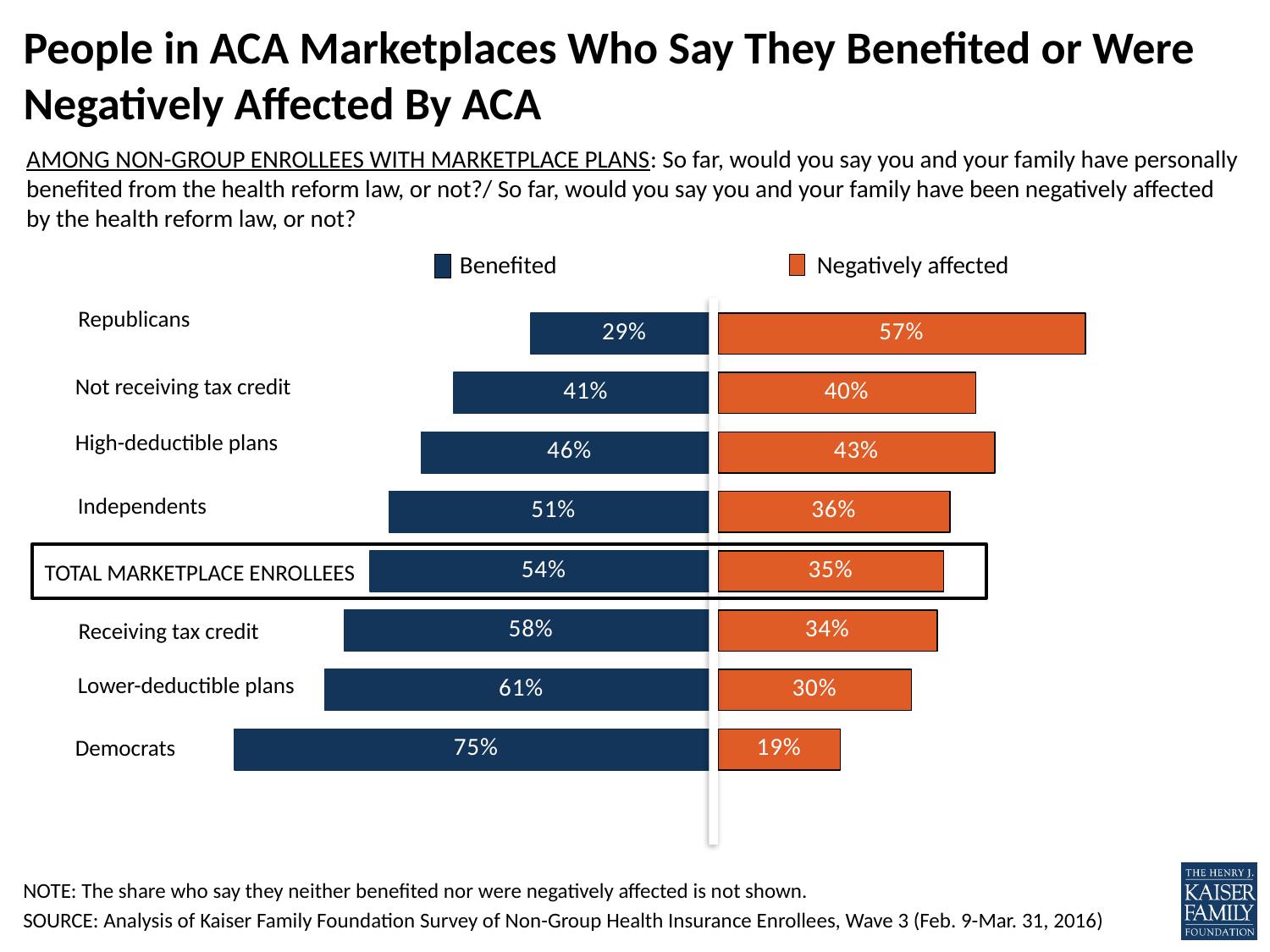
What percentage of Republicans say they benefited from the ACA? 29% How many groups are shown in the chart? 8 Which colour represents the 'Negatively affected' series? Orange Among those receiving a tax credit, which is larger: the share who benefited or the share negatively affected? Benefited What percentage of Democrats say they were negatively affected by the ACA? 19% What type of chart is shown on the slide? Bar chart Which group has the highest share saying they benefited? Democrats What percentage of total marketplace enrollees say they benefited? 54% What is the difference between the share of Democrats and the share of Republicans who say they benefited? 46 percentage points How many series does the legend list? 2 Which group has the highest share saying they were negatively affected? Republicans Which group has the lowest share saying they were negatively affected? Democrats